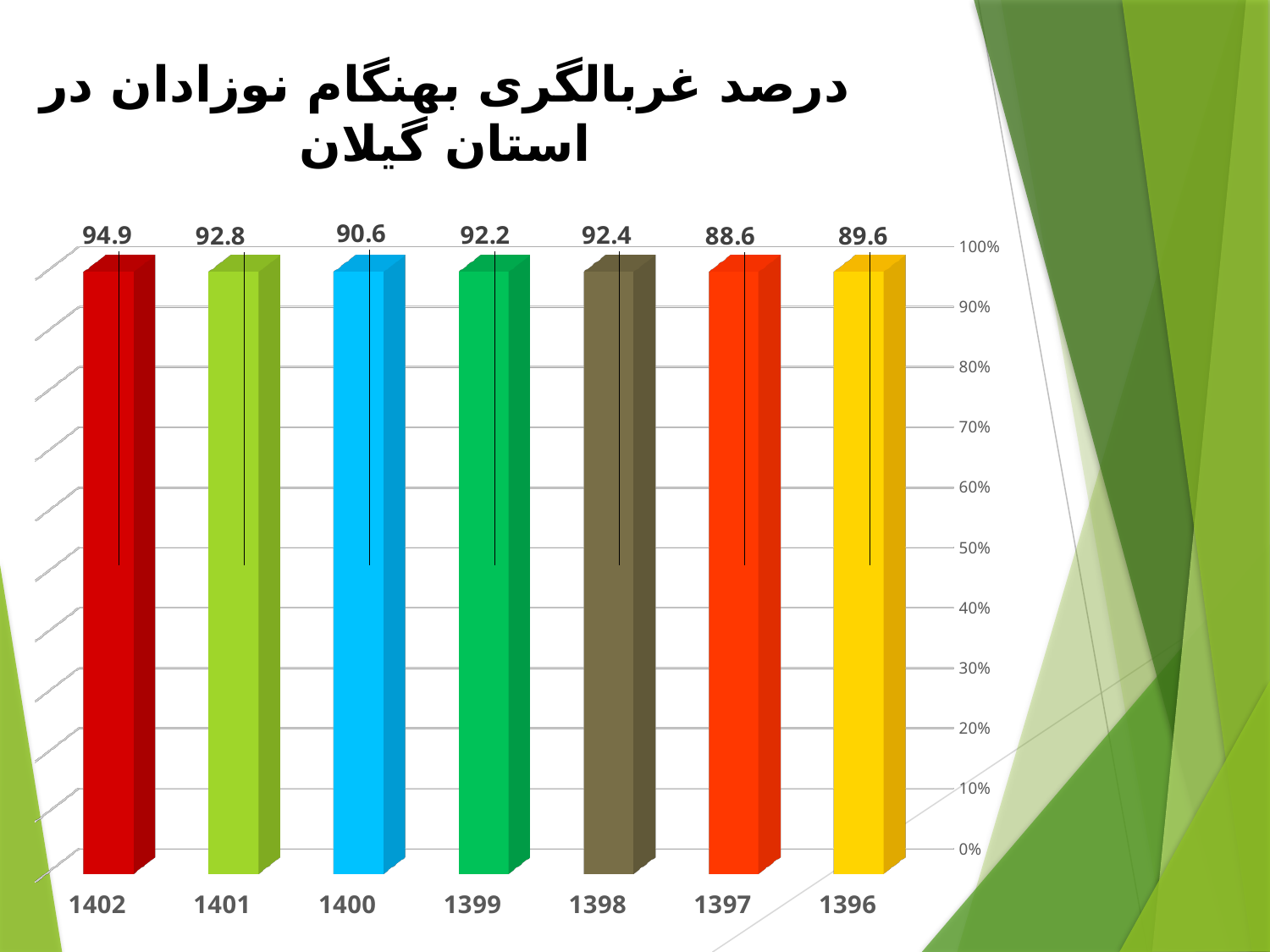
Which year has the highest value? 1402 What is the highest tick value shown on the vertical axis? 100% What is the value for 1396? 89.6 What is the difference between the values for 1401 and 1400? 2.2 What is the value for 1402? 94.9 How many years are shown on the chart? 7 What is the difference between the values for 1402 and 1397? 6.3 Which is larger, the value for 1401 or the value for 1400? 1401 Which year has the lowest value? 1397 What is the value for 1400? 90.6 What is the value for 1397? 88.6 What kind of chart is shown on the slide? bar chart